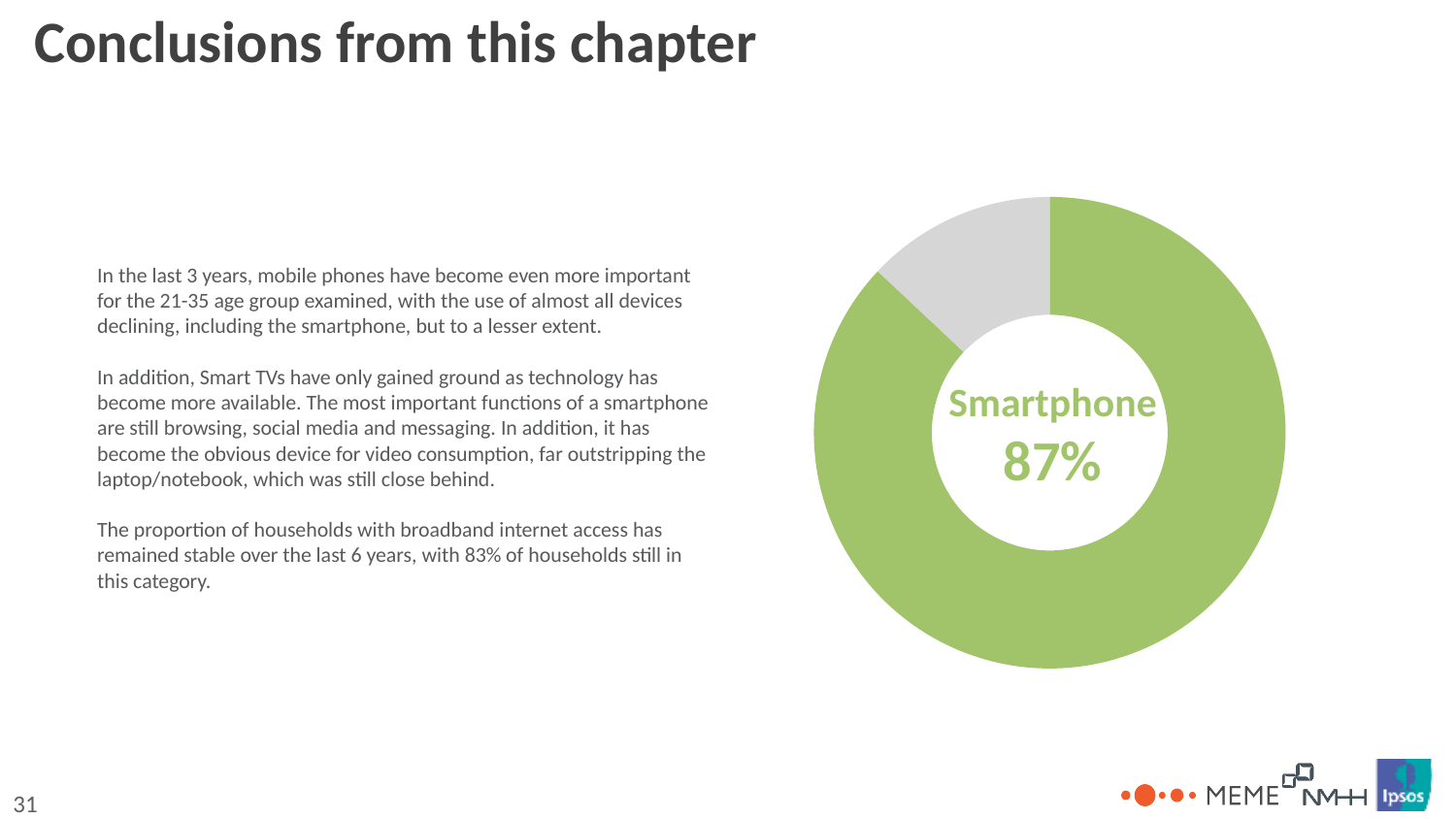
What colour is the Smartphone slice in the donut chart? Green Which slice of the donut chart is larger, the green one or the grey one? The green one What value is shown for Smartphone in the donut chart? 87% What share of the donut chart does the Smartphone slice represent? 87% What label is printed in the centre of the donut chart? Smartphone 87% What kind of chart is shown on the slide? Pie chart (donut) How many slices does the donut chart have? 2 Is the Smartphone share in the donut chart greater or less than 50%? greater Is the grey slice of the donut chart greater or less than 50%? less